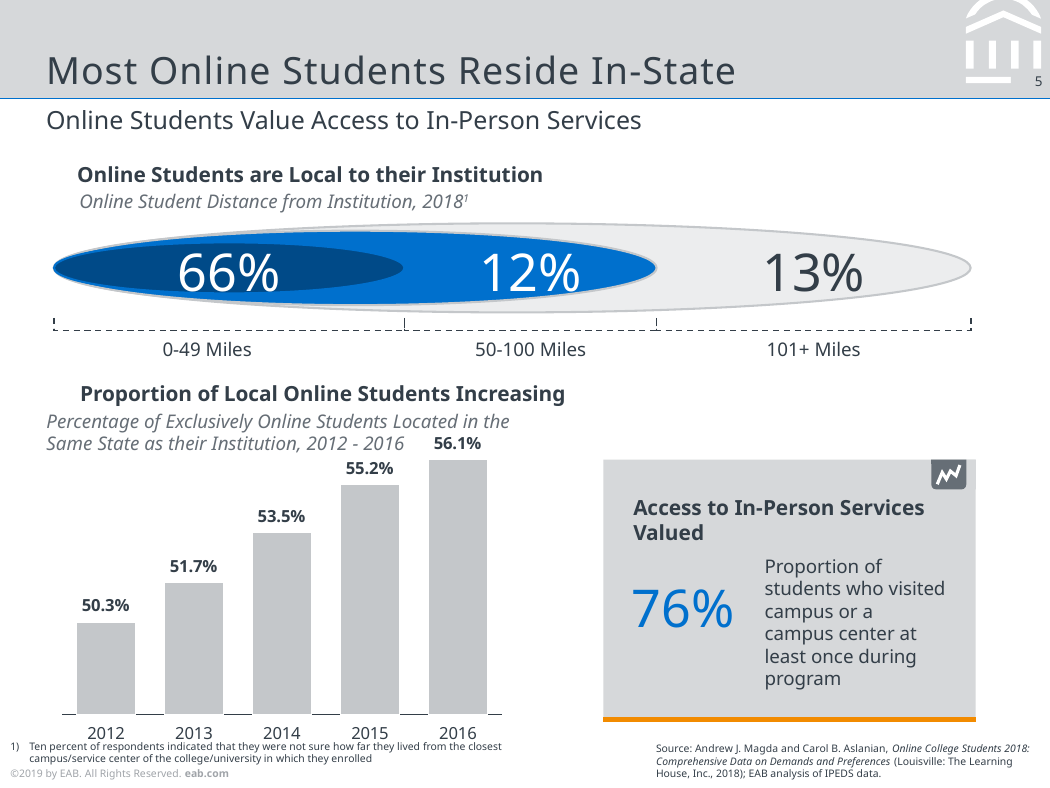
In the 'Proportion of Local Online Students Increasing' chart, which is larger, the value for 2013 or the value for 2014? 2014 How many years are shown in the 'Proportion of Local Online Students Increasing' chart? 5 In the 'Proportion of Local Online Students Increasing' chart, what is the difference between the 2016 and 2012 values? 5.8% In the 'Proportion of Local Online Students Increasing' chart, what is the value for 2012? 50.3% In the 'Online Students are Local to their Institution' graphic, which distance category has the smallest share? 50-100 Miles In the 'Online Students are Local to their Institution' graphic, what percentage of online students are 0-49 miles from their institution? 66% In the 'Proportion of Local Online Students Increasing' chart, what is the value for 2015? 55.2% In the 'Proportion of Local Online Students Increasing' chart, which year has the lowest value? 2012 What kind of chart is the 'Proportion of Local Online Students Increasing' chart? bar chart In the 'Proportion of Local Online Students Increasing' chart, do the values rise or fall from 2012 to 2016? rise In the 'Proportion of Local Online Students Increasing' chart, which year has the highest value? 2016 In the 'Online Students are Local to their Institution' graphic, what percentage of online students are 101+ miles from their institution? 13%